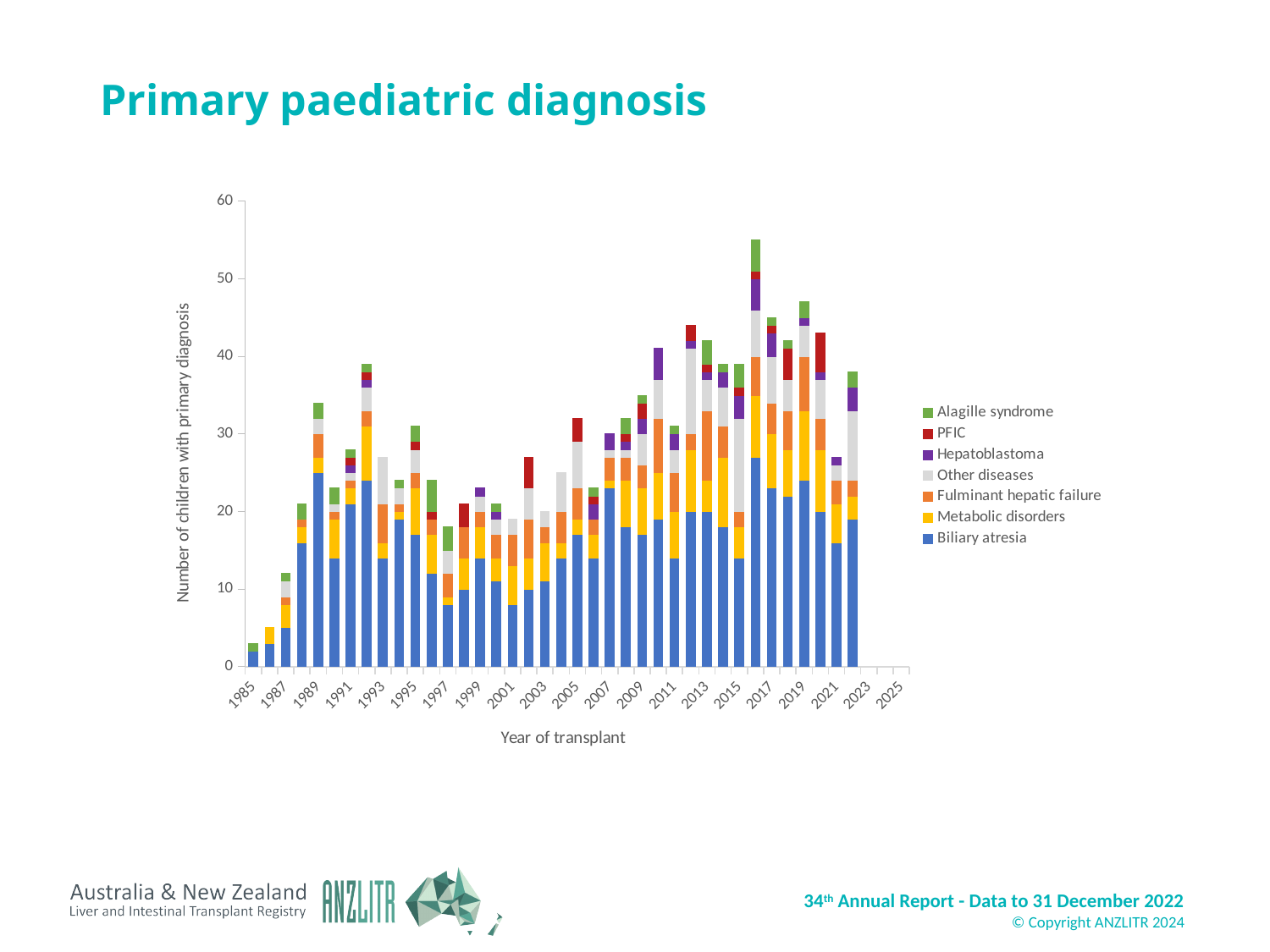
Which year has a taller stacked bar, 1988 or 1989? 1989 Is the total number of children for 2016 greater or less than 50? greater Is the total number of children for 2020 greater or less than 40? greater What is the title of the x axis? Year of transplant Do the bar totals rise or fall from 1985 to 1989? rise Which year has a taller stacked bar, 2016 or 2020? 2016 Which year has the shortest stacked bar? 1985 What kind of chart is shown on the slide? Stacked bar chart Is the total number of children for 1985 greater or less than 10? less Which year has the tallest stacked bar? 2016 How many series does the legend list? 7